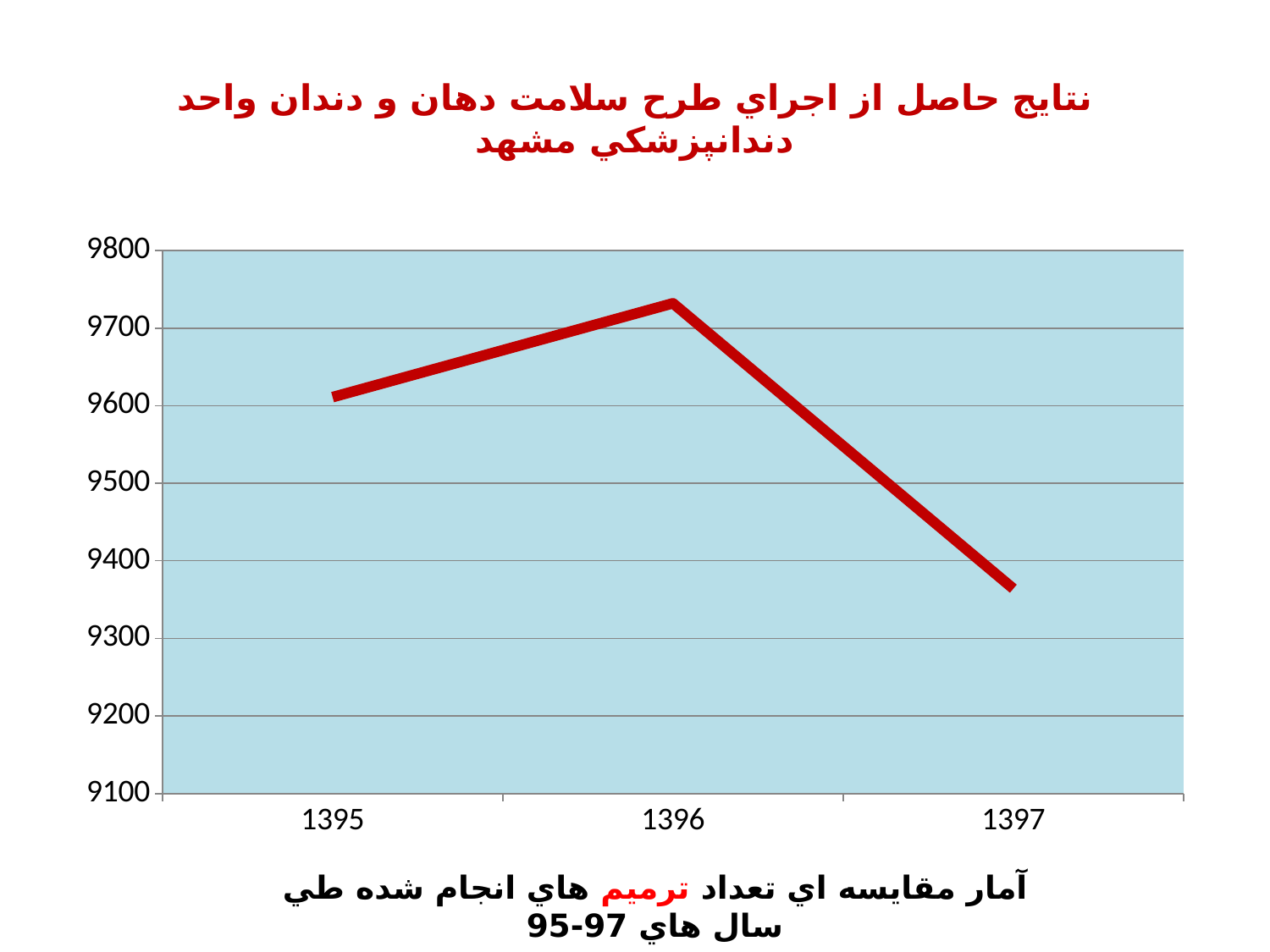
Which year has the highest value on the chart? 1396 Which year has the larger value, 1395 or 1397? 1395 What colour is the line plotted on the chart? red Which year has the larger value, 1395 or 1396? 1396 How many years are plotted on the x axis of the chart? 3 Is the value for 1396 greater or less than 9700? greater Does the line rise or fall between 1395 and 1396? rise Which year has the lowest value on the chart? 1397 What kind of chart is shown on the slide? line chart Is the value for 1397 greater or less than 9400? less Does the line rise or fall between 1396 and 1397? fall